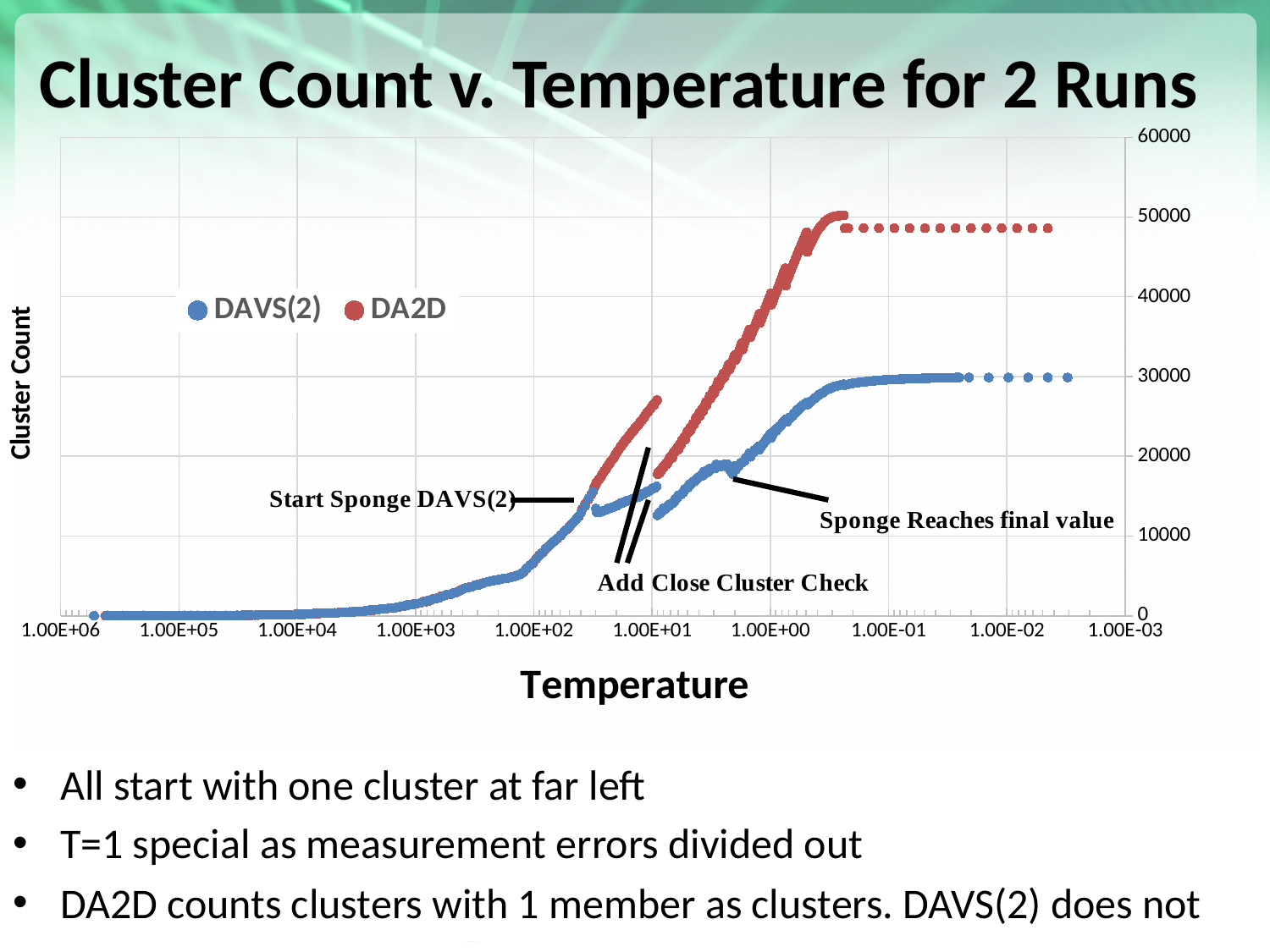
Which series is plotted in red? DA2D What is the title of the chart? Cluster Count v. Temperature for 2 Runs Is the final (rightmost) cluster count for DAVS(2) greater or less than 20000? greater Which series reaches a higher maximum cluster count, DAVS(2) or DA2D? DA2D Is the final (rightmost) cluster count for DA2D greater or less than 40000? greater What kind of chart is shown on the slide? Scatter chart At the far right of the chart, which series has the higher cluster count, DAVS(2) or DA2D? DA2D How many series does the legend list? 2 Moving from left to right along the x axis, do the cluster counts generally rise or fall? rise Is the cluster count for DAVS(2) at the far left of the chart (temperature 1.00E+06) greater or less than 10000? less